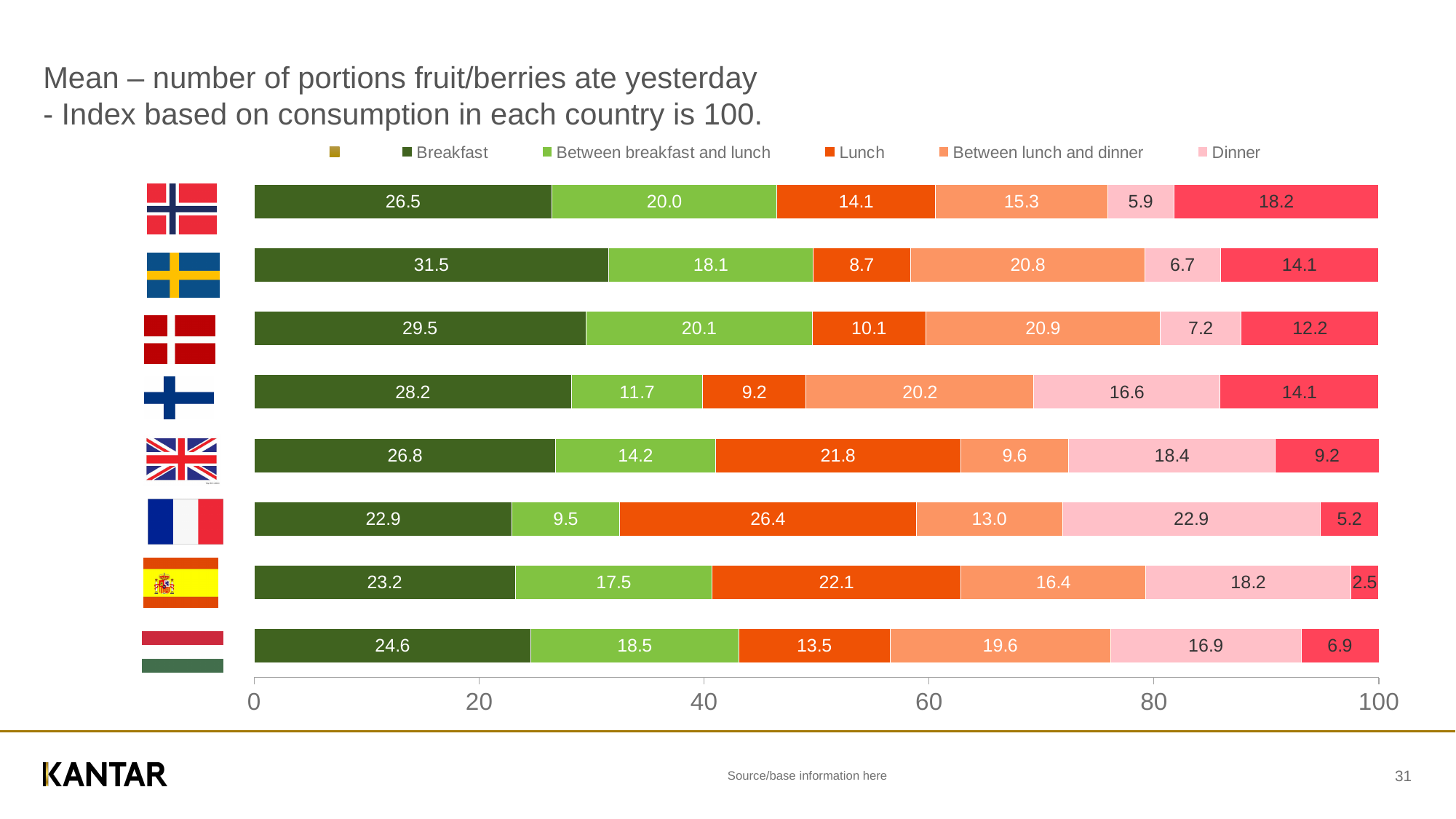
How many bars (countries) are shown in the chart? 8 What is the 'Between lunch and dinner' value for the third bar from the top (Danish flag)? 20.9 What is the Dinner value for the fourth bar from the top (Finnish flag)? 16.6 What kind of chart is shown on the slide? Stacked bar chart For the top bar (Norwegian flag), what is the difference between the Breakfast value and the Lunch value? 12.4 Which bar has the highest Lunch value? The sixth bar from the top (French flag), 26.4 What is the Lunch value for the sixth bar from the top (French flag)? 26.4 What is the maximum value shown on the x axis? 100 Which bar has the highest Breakfast value? The second bar from the top (Swedish flag), 31.5 Which is larger: the Lunch value for the fifth bar (UK flag) or the Lunch value for the top bar (Norwegian flag)? The fifth bar (UK flag), 21.8 Which bar has the lowest Breakfast value? The sixth bar from the top (French flag), 22.9 What is the Breakfast value for the top bar (Norwegian flag)? 26.5